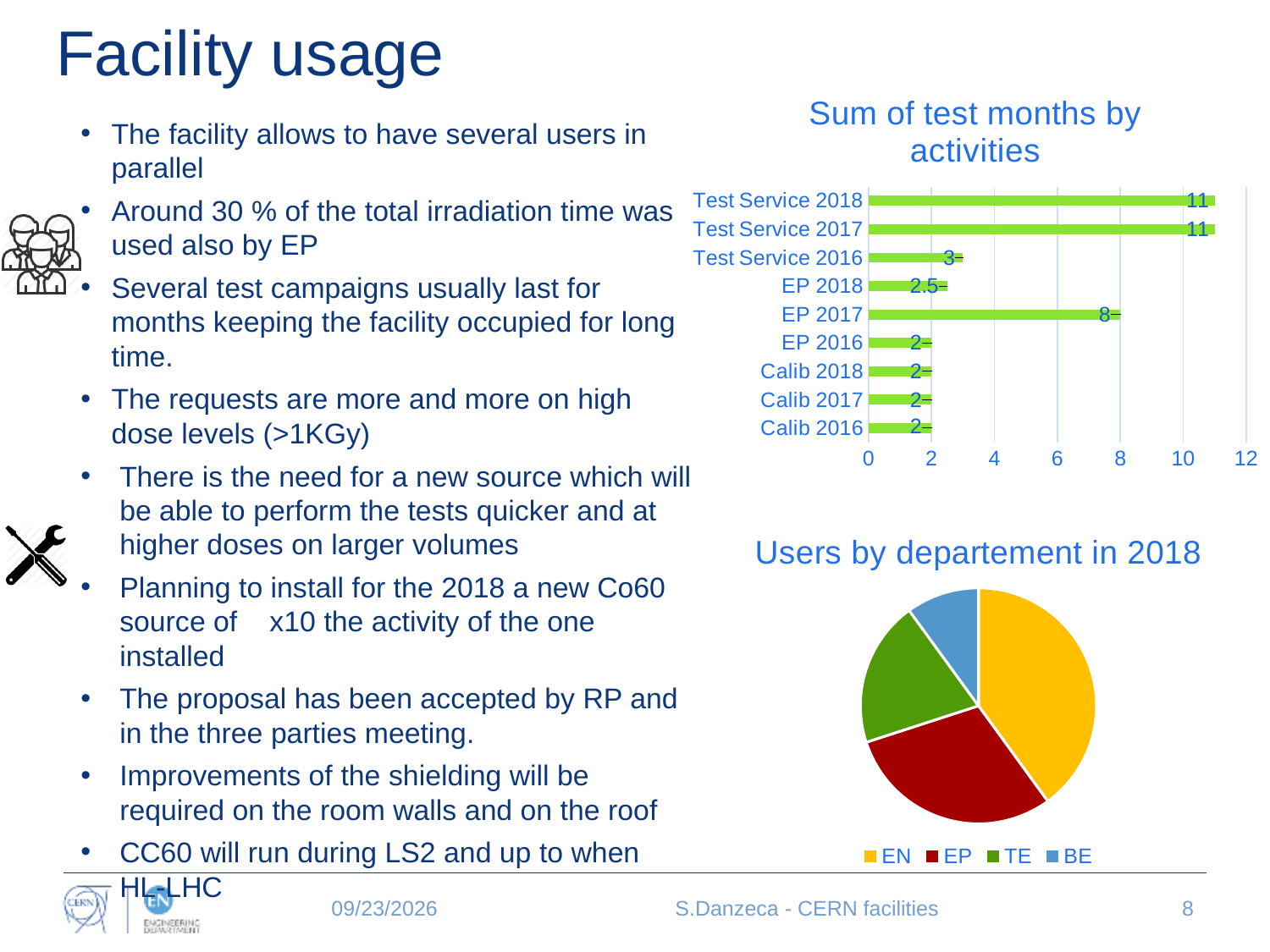
In the 'Sum of test months by activities' chart, which is larger, EP 2017 or Test Service 2016? EP 2017 In the 'Users by departement in 2018' chart, which department has the smallest slice? BE In the 'Sum of test months by activities' chart, what is the value for EP 2017? 8 In the 'Sum of test months by activities' chart, is the value for Test Service 2018 greater or less than 10? greater In the 'Sum of test months by activities' chart, what is the difference between Test Service 2017 and EP 2017? 3 In the 'Sum of test months by activities' chart, how many categories are shown? 9 How many entries does the legend of the 'Users by departement in 2018' chart list? 4 In the 'Sum of test months by activities' chart, what is the value for Calib 2017? 2 In the 'Sum of test months by activities' chart, what is the value for EP 2018? 2.5 In the 'Users by departement in 2018' chart, which department has the largest slice? EN In the 'Sum of test months by activities' chart, what is the value for Test Service 2016? 3 What kind of chart is 'Sum of test months by activities'? Bar chart